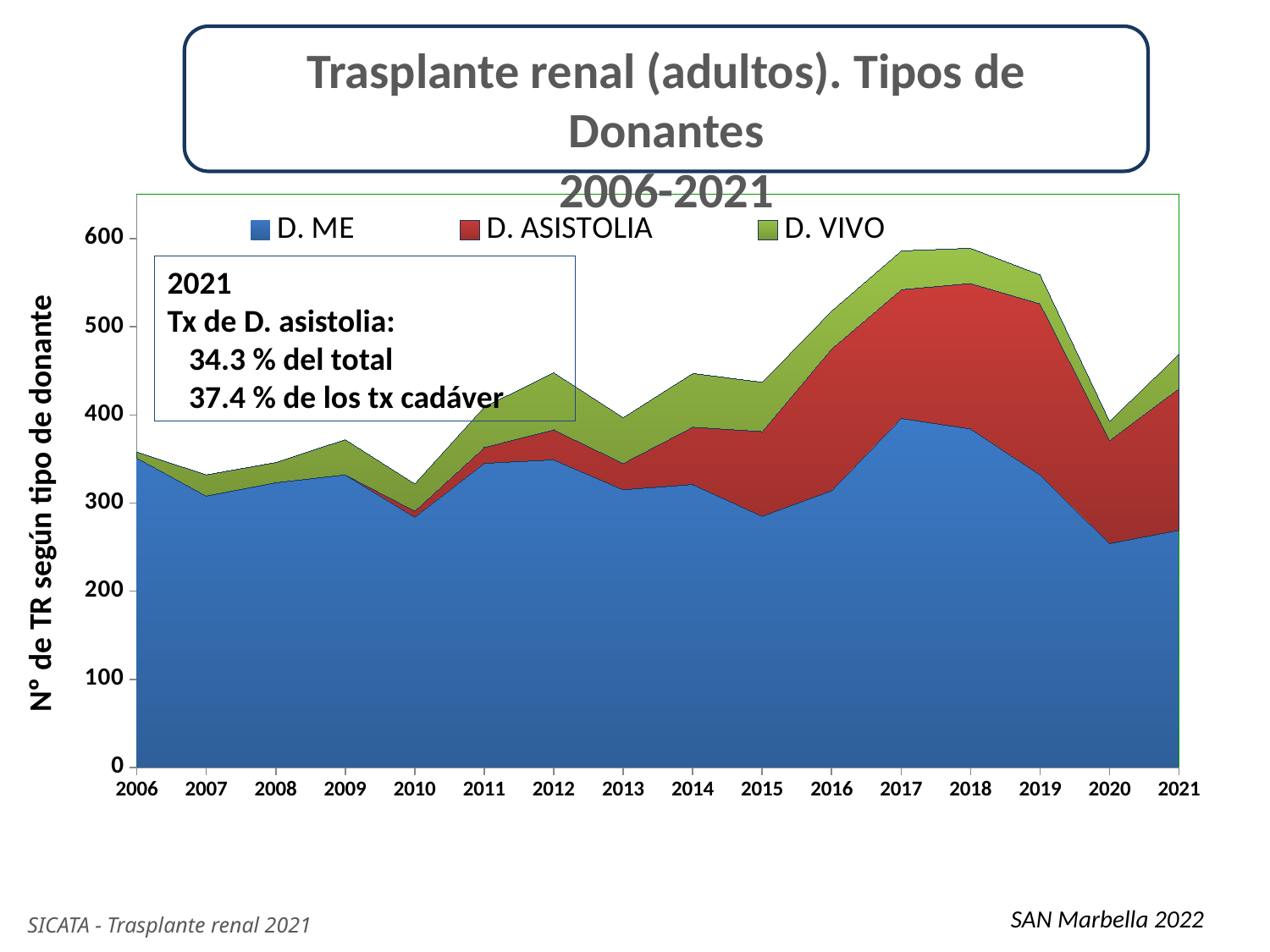
What kind of chart is shown on the slide? Stacked area chart How many series does the legend list? 3 What is the label of the vertical axis? Nº de TR según tipo de donante Is the total of all donor types in 2010 greater or less than 400? less Is the value for D. ME in 2006 greater or less than 300? greater Does the total number of transplants rise or fall from 2015 to 2017? rise Is the value for D. ME in 2020 greater or less than 300? less Does the value for D. ME rise or fall from 2018 to 2020? fall How many years are plotted along the x axis? 16 Which series is shown in green in the legend? D. VIVO